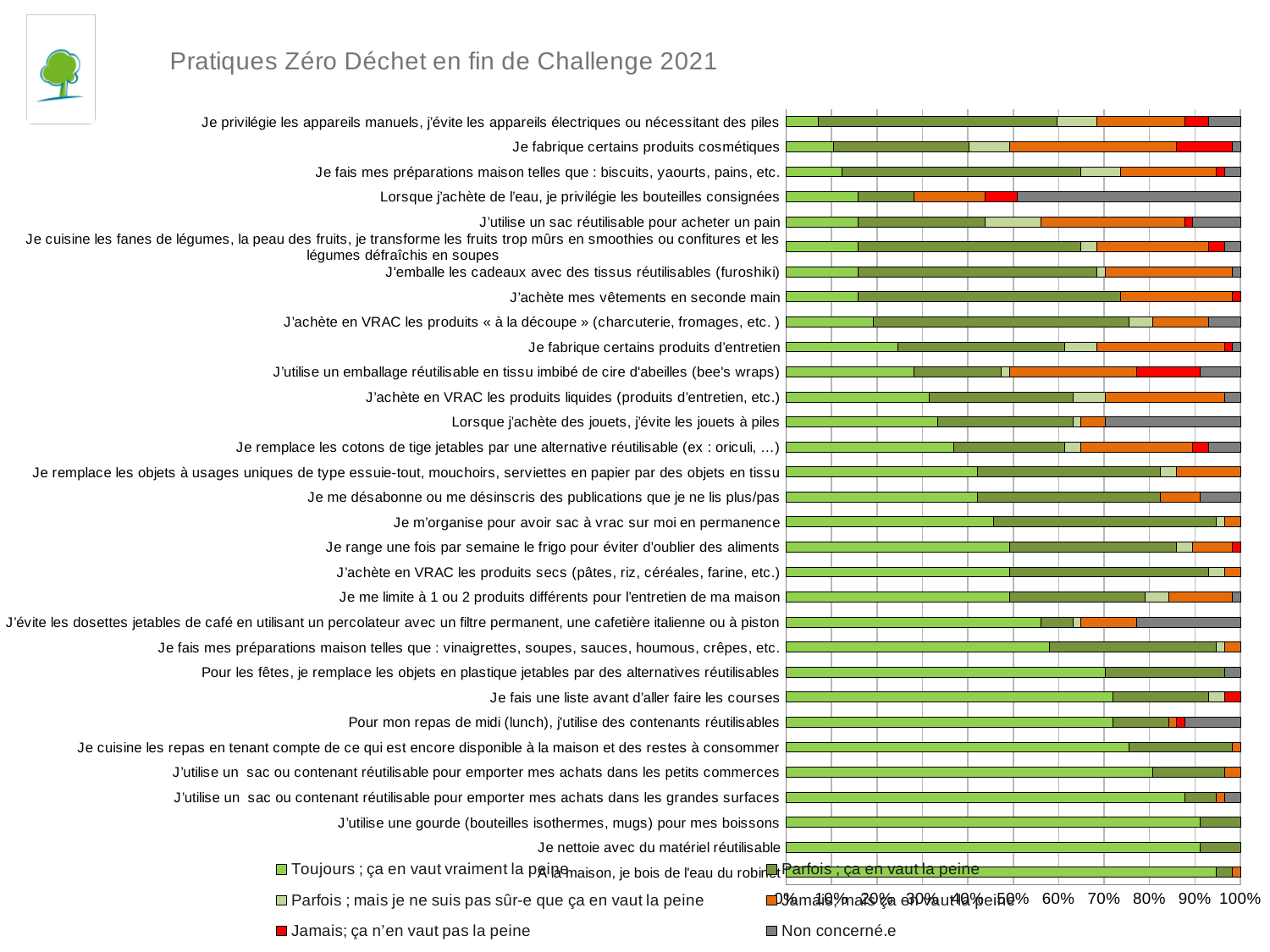
What is the title of the chart? Pratiques Zéro Déchet en fin de Challenge 2021 How many practices (categories) are plotted on the chart? 31 Is the 'Toujours ; ça en vaut vraiment la peine' share for 'Je privilégie les appareils manuels, j'évite les appareils électriques ou nécessitant des piles' greater or less than 10%? less Which has the larger 'Toujours ; ça en vaut vraiment la peine' share: 'Je fais une liste avant d'aller faire les courses' or 'Je fabrique certains produits cosmétiques'? Je fais une liste avant d'aller faire les courses Is the 'Toujours ; ça en vaut vraiment la peine' share for 'J'utilise une gourde (bouteilles isothermes, mugs) pour mes boissons' greater or less than 80%? greater What kind of chart is shown on the slide? Stacked bar chart Which practice has the smallest 'Toujours ; ça en vaut vraiment la peine' share? Je privilégie les appareils manuels, j'évite les appareils électriques ou nécessitant des piles Is the 'Toujours ; ça en vaut vraiment la peine' share for 'Je fais une liste avant d'aller faire les courses' greater or less than 60%? greater What colour represents the 'Non concerné.e' series in the legend? Grey Which has the larger 'Non concerné.e' share: 'Lorsque j'achète de l'eau, je privilégie les bouteilles consignées' or 'Je fais une liste avant d'aller faire les courses'? Lorsque j'achète de l'eau, je privilégie les bouteilles consignées How many series does the legend list? 6